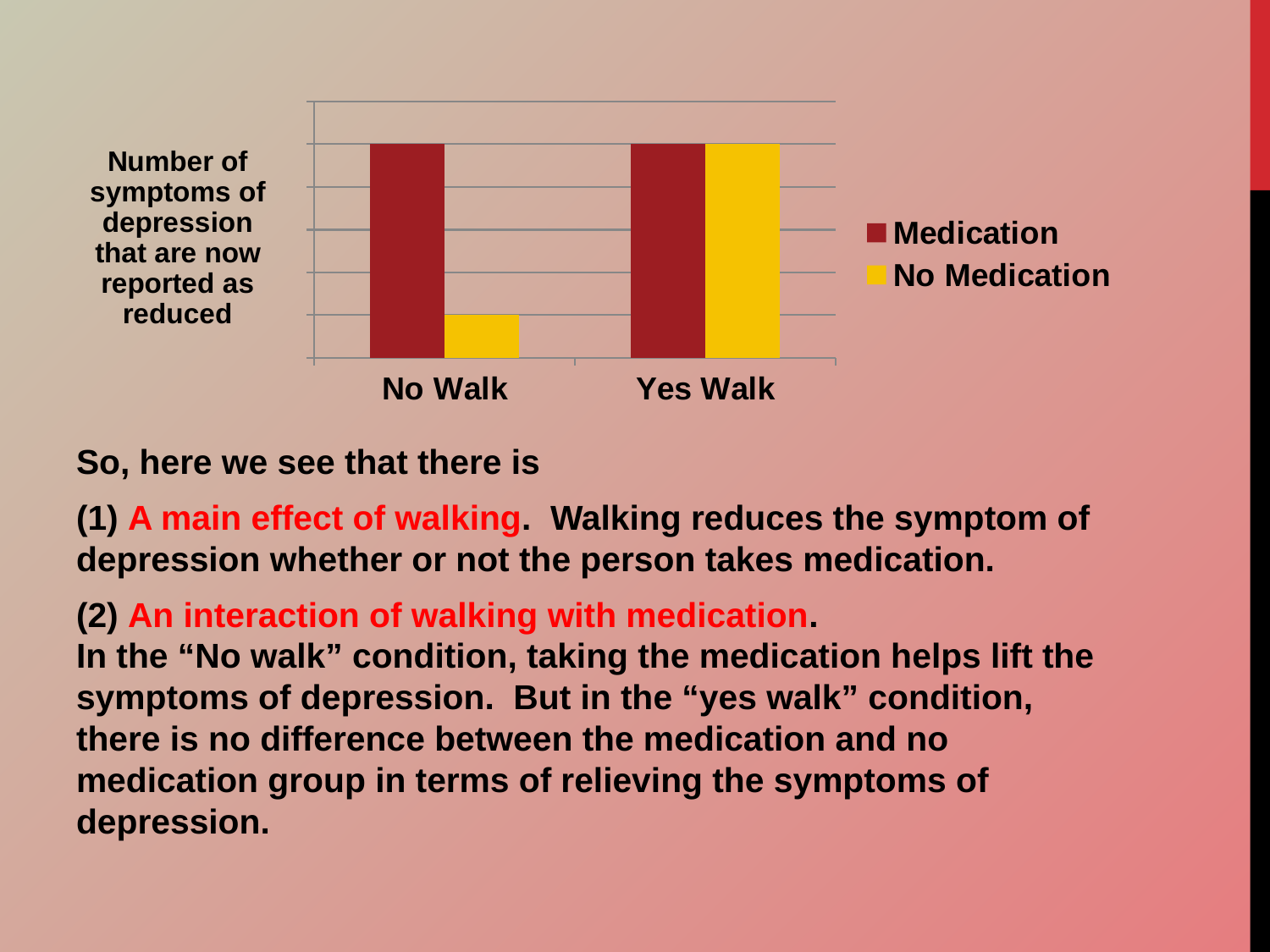
In the No Walk condition, which is larger: the Medication bar or the No Medication bar? Medication Which bar is the lowest in the chart? No Medication in the No Walk condition What does the vertical axis label say the chart measures? Number of symptoms of depression that are now reported as reduced Does the No Medication series rise or fall from No Walk to Yes Walk? Rise What are the two series named in the legend? Medication and No Medication What kind of chart is shown on the slide? Bar chart How many categories are shown on the x axis? 2 For the No Medication series, which condition has the larger value: No Walk or Yes Walk? Yes Walk How many series does the legend list? 2